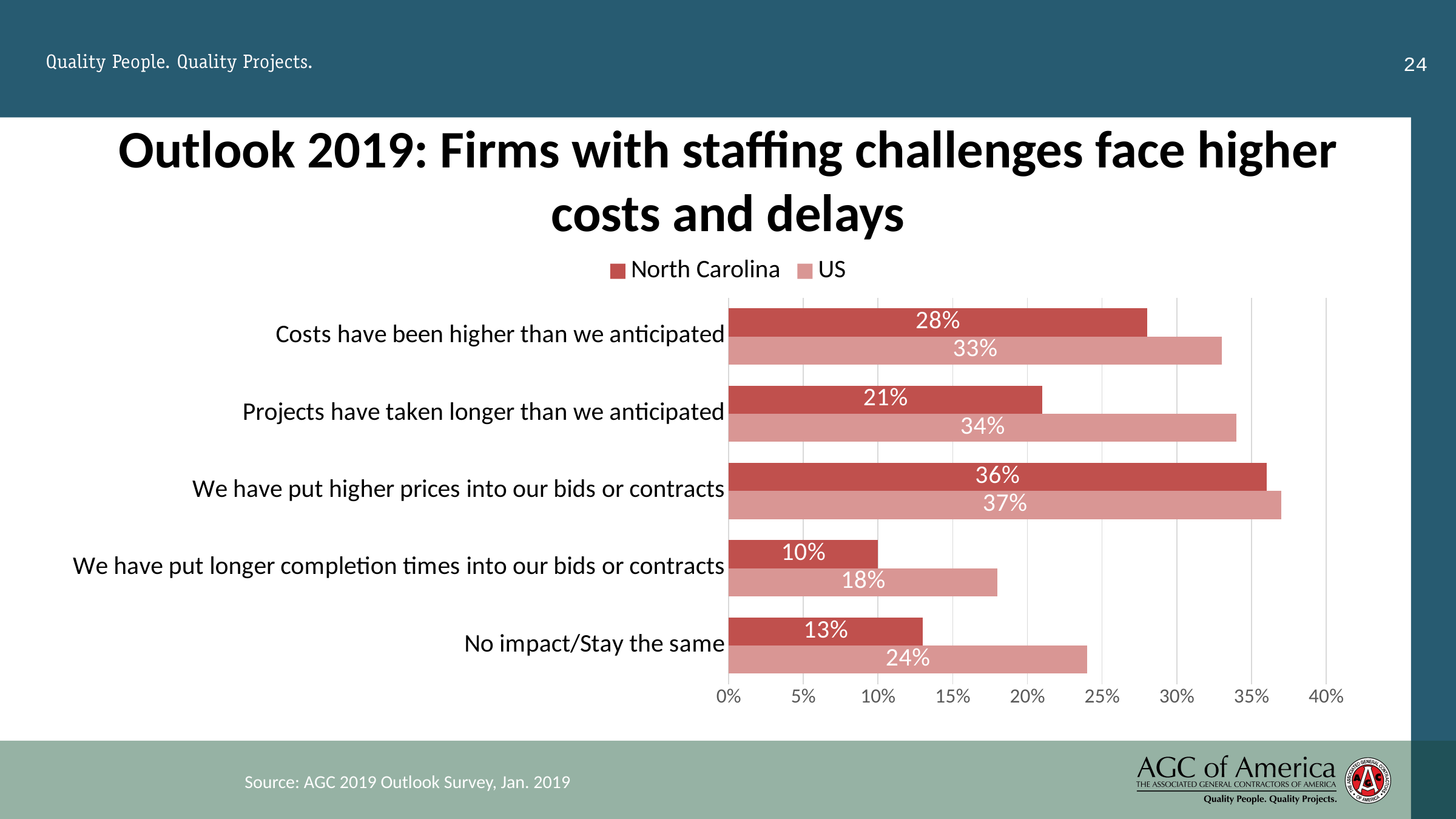
Which category has the highest North Carolina value? We have put higher prices into our bids or contracts How many categories are shown on the chart? 5 How many series does the legend list? 2 What is the difference between the US and North Carolina values for "Projects have taken longer than we anticipated"? 13% What is the US value for "Projects have taken longer than we anticipated"? 34% What is the North Carolina value for "Costs have been higher than we anticipated"? 28% What is the North Carolina value for "We have put longer completion times into our bids or contracts"? 10% What are the two series named in the legend? North Carolina and US What kind of chart is shown on the slide? Bar chart For "No impact/Stay the same", which is larger: the North Carolina value or the US value? US What is the US value for "No impact/Stay the same"? 24% Which category has the lowest US value? We have put longer completion times into our bids or contracts